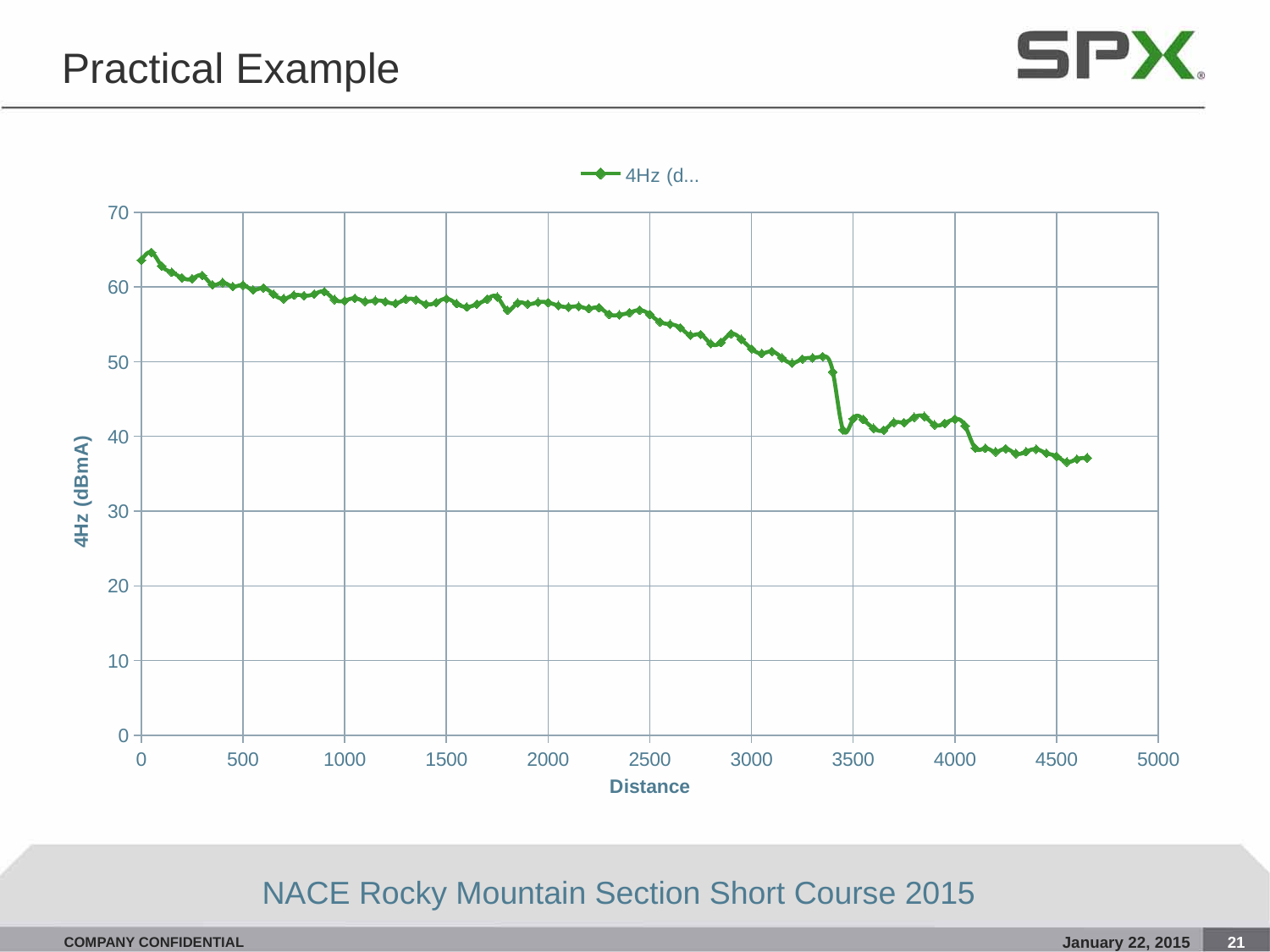
Is the value at Distance 2000 greater or less than 50? greater Is the value at Distance 1000 greater or less than 50? greater What kind of chart is shown on the slide? line chart Is the value at Distance 0 greater or less than 60? greater Which is larger, the value at Distance 500 or the value at Distance 4000? Distance 500 What is the title of the x axis? Distance Do the values generally rise or fall as Distance increases? fall How many series does the legend list? 1 What is the highest value shown on the y axis? 70 What is the title of the y axis? 4Hz (dBmA)